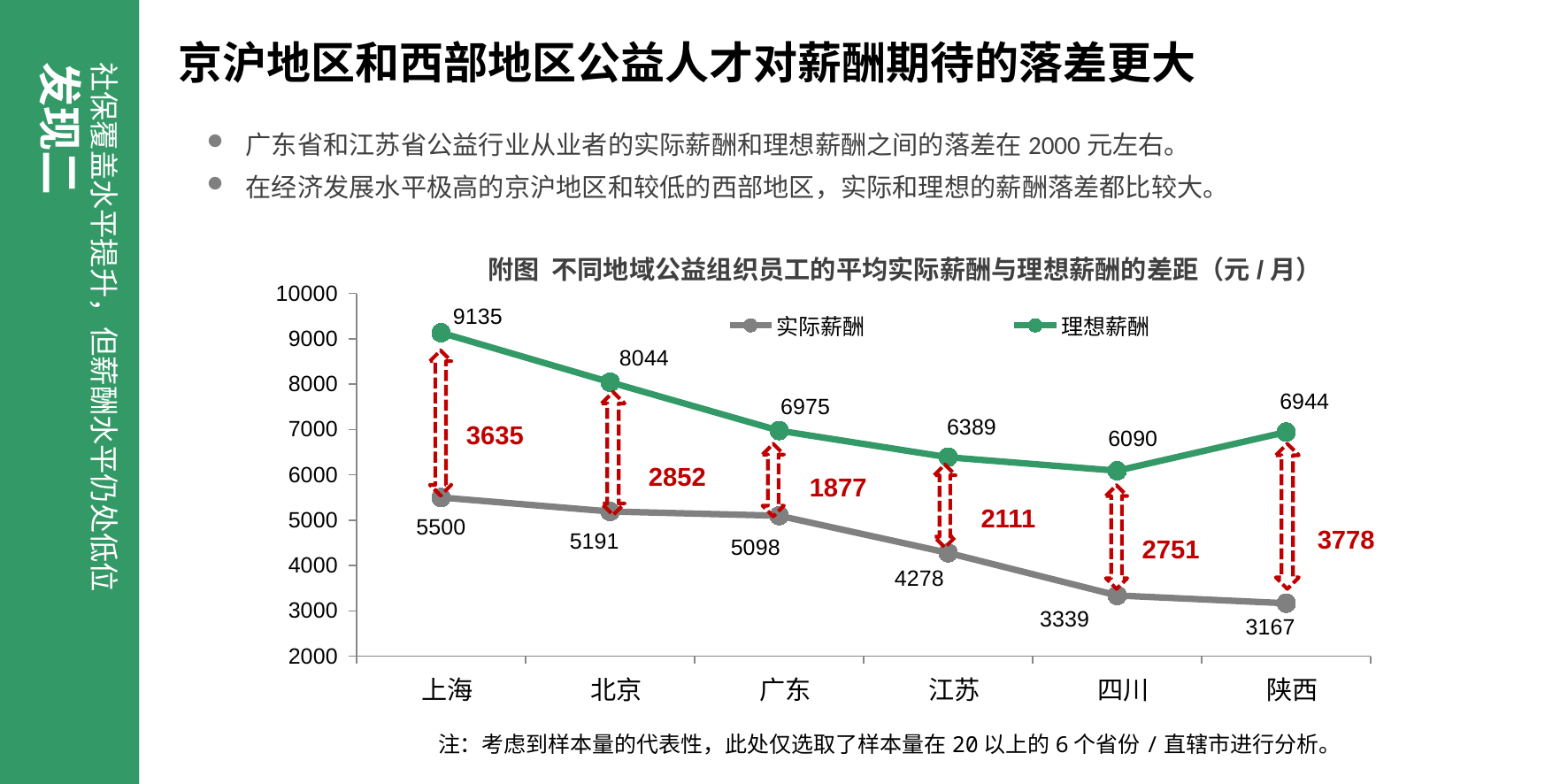
How many regions are plotted on the x axis? 6 Which is larger, the 实际薪酬 for 江苏 or the 实际薪酬 for 北京? 北京 How many series does the legend list? 2 What is the difference between 理想薪酬 and 实际薪酬 for 广东? 1877 What is the 实际薪酬 value for 四川? 3339 Which region has the lowest 理想薪酬? 四川 What is the 理想薪酬 value for 上海? 9135 What type of chart is shown on the slide? line chart Does the 实际薪酬 series generally rise or fall from 上海 to 陕西? fall What is the 理想薪酬 value for 陕西? 6944 Which region has the highest 实际薪酬? 上海 Which colour is used for the 理想薪酬 line? green